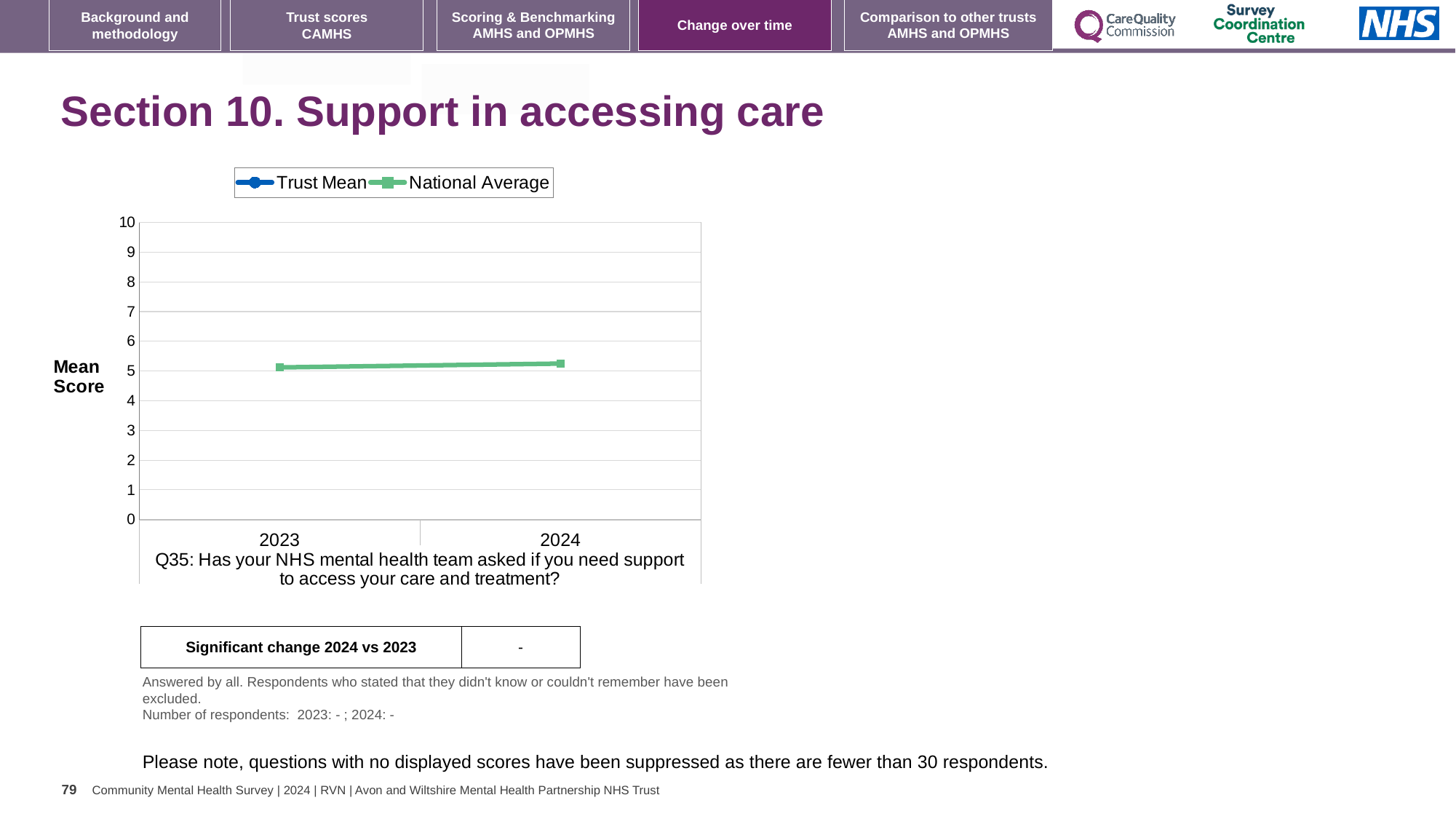
Is the National Average value for 2023 greater or less than 6? less Does the National Average line rise or fall from 2023 to 2024? Rises How many series does the chart legend list? 2 What is the label on the y axis of the chart? Mean Score Which series is plotted on the chart, Trust Mean or National Average? National Average What is the highest value shown on the y axis of the chart? 10 What kind of chart is shown on the slide? Line chart Which years are shown on the x axis of the chart? 2023 and 2024 Is the National Average value for 2024 greater or less than 4? greater How many years are shown on the x axis of the chart? 2 Is the National Average value for 2024 greater or less than 7? less Which two series are listed in the chart legend? Trust Mean and National Average